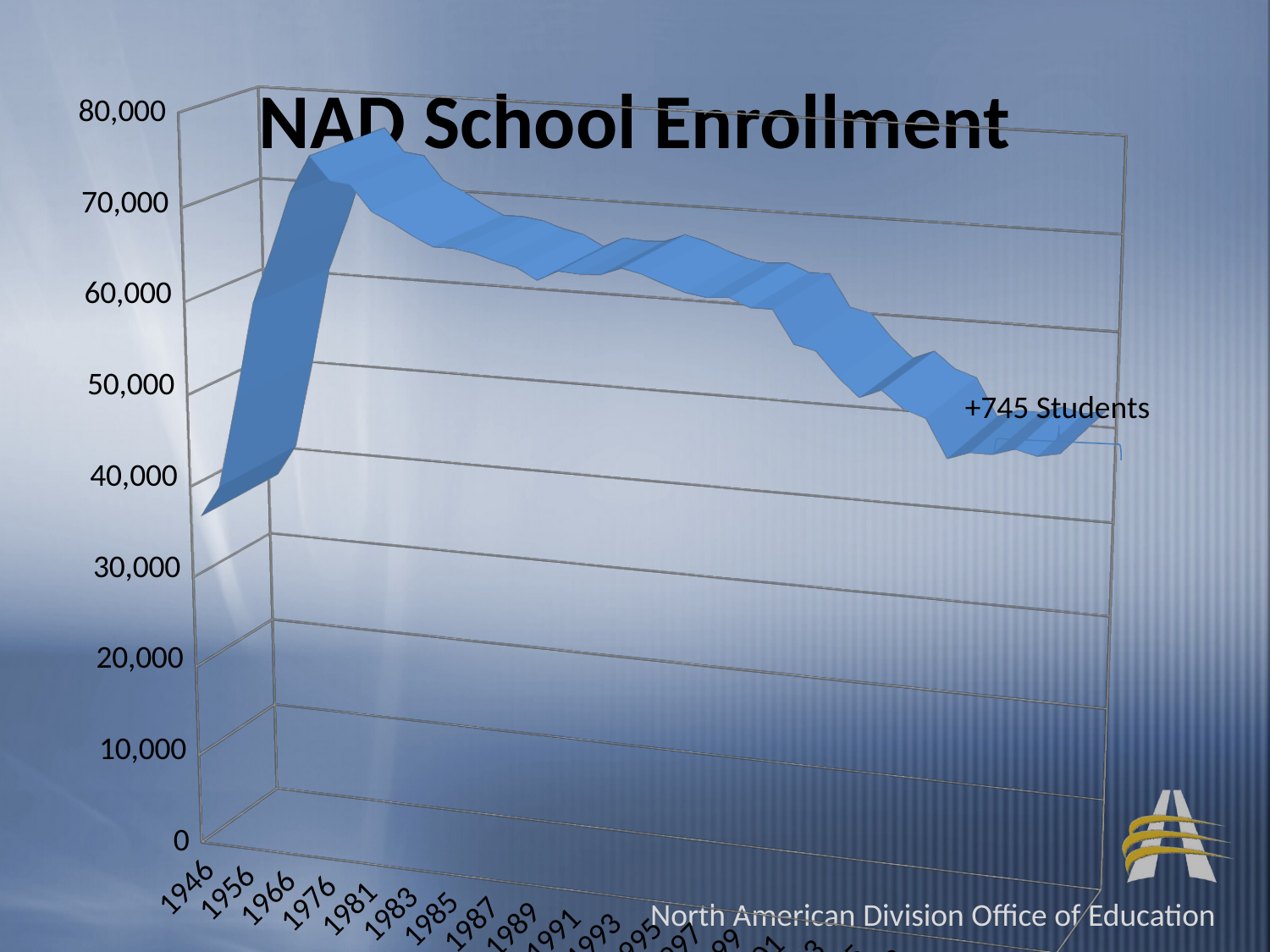
Which year has the larger enrollment, 1946 or 1966? 1966 Is the enrollment value for 1976 greater or less than 70,000? greater What is the highest value shown on the vertical axis of the chart? 80,000 What is the title of the chart? NAD School Enrollment Which year on the x axis has the highest enrollment? 1976 Which year has the larger enrollment, 1976 or 1991? 1976 Is the enrollment value for 1966 greater or less than 50,000? greater Is the enrollment value for 1946 greater or less than 40,000? less Do enrollment values rise or fall along the x axis from 1946 to 1976? rise Do enrollment values rise or fall along the x axis from 1976 onward? fall What does the annotation near the right end of the line say? +745 Students What kind of chart is shown on the slide? line chart